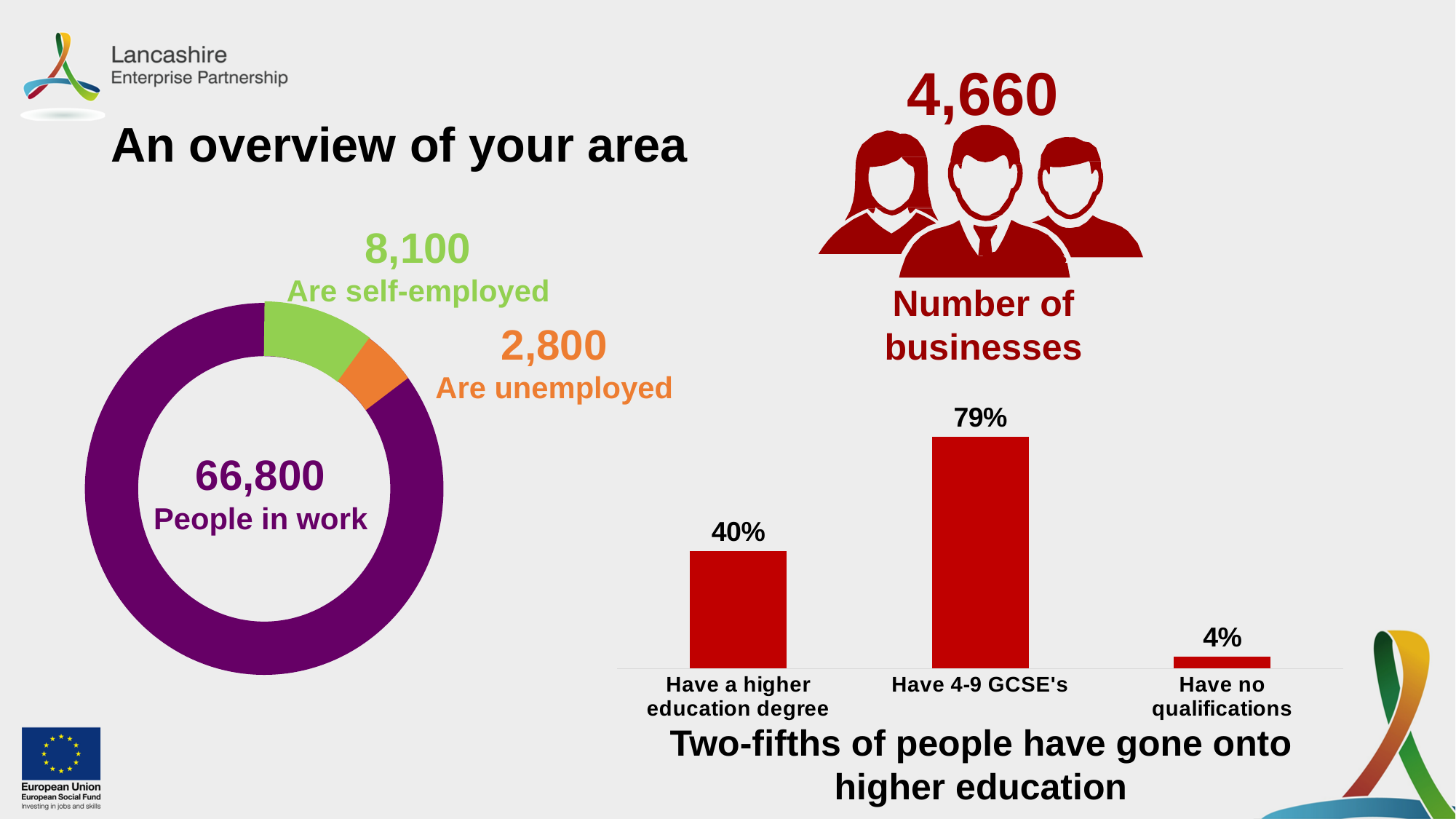
In the bar chart on the right, what is the difference in percentage points between 'Have 4-9 GCSE's' and 'Have a higher education degree'? 39 percentage points In the bar chart on the right, how many categories are shown? 3 In the donut chart on the left, how many people are in work? 66,800 In the bar chart on the right, which category has the lowest value? Have no qualifications In the bar chart on the right, what percentage of people have 4-9 GCSE's? 79% In the donut chart on the left, what is the difference between the number of self-employed people and the number of unemployed people? 5,300 In the donut chart on the left, which is larger: the number of self-employed people or the number of unemployed people? Self-employed In the donut chart on the left, how many people are self-employed? 8,100 What kind of chart is shown on the right of the slide? Bar chart In the bar chart on the right, which category has the highest value? Have 4-9 GCSE's In the bar chart on the right, what percentage of people have a higher education degree? 40% In the bar chart on the right, what percentage of people have no qualifications? 4%